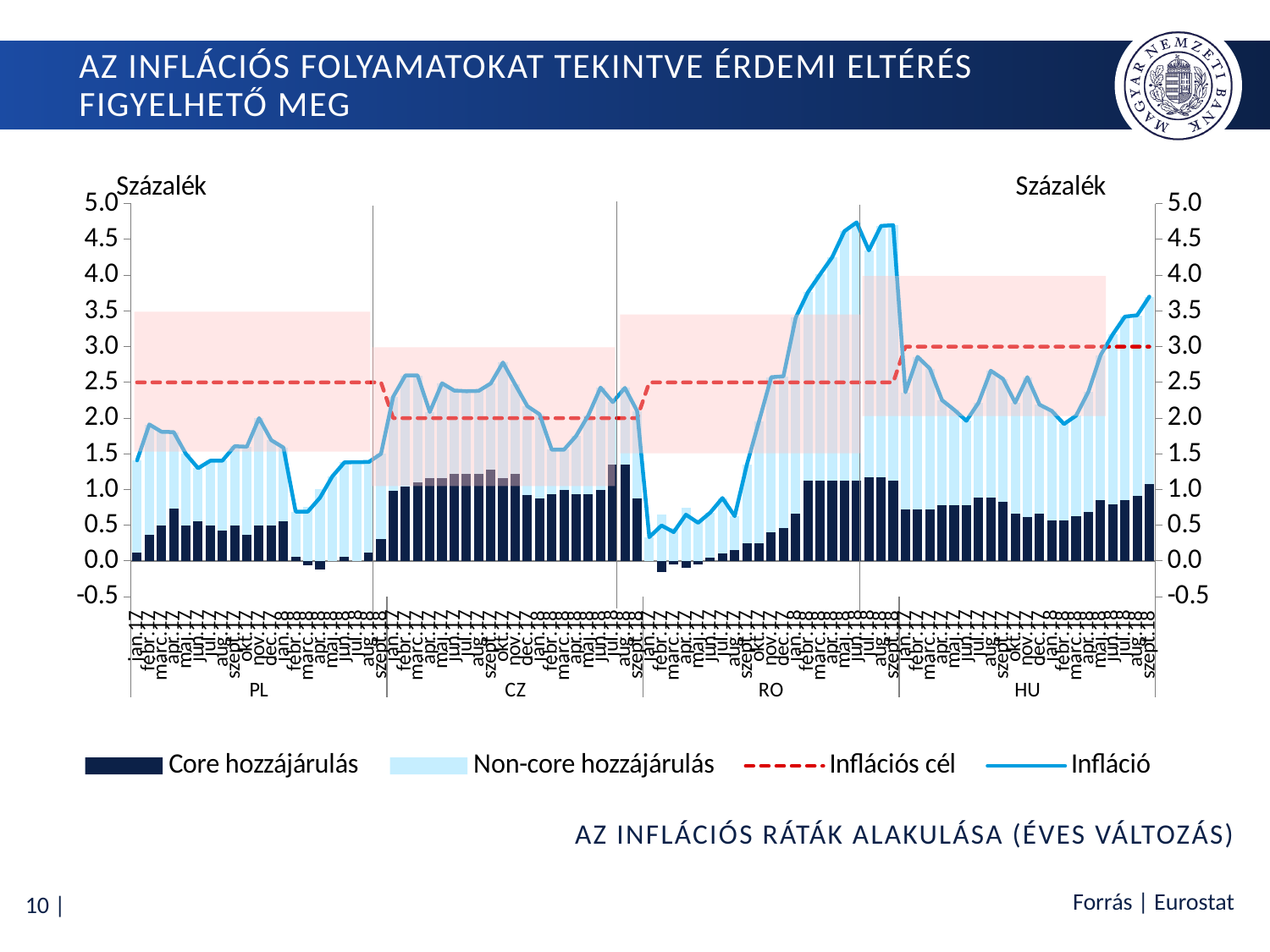
Is the peak value of the Infláció line in the RO panel greater or less than 4.0? greater What is the inflation target (Inflációs cél) shown for PL? 2.5 What is the label of the vertical axis? Százalék Which country panel shows the highest peak of the Infláció line? RO What kind of chart is shown on the slide? A combined stacked bar and line chart What is the inflation target (Inflációs cél) shown for CZ? 2.0 Which country's inflation target is higher, HU or CZ? HU Is the Infláció value for PL in febr. 18 greater or less than 1.0? less What is the inflation target (Inflációs cél) shown for HU? 3.0 How many country panels are shown along the x axis? 4 Does the Infláció line in the HU panel rise or fall from jan. 18 to szept. 18? rise How many series does the legend list? 4